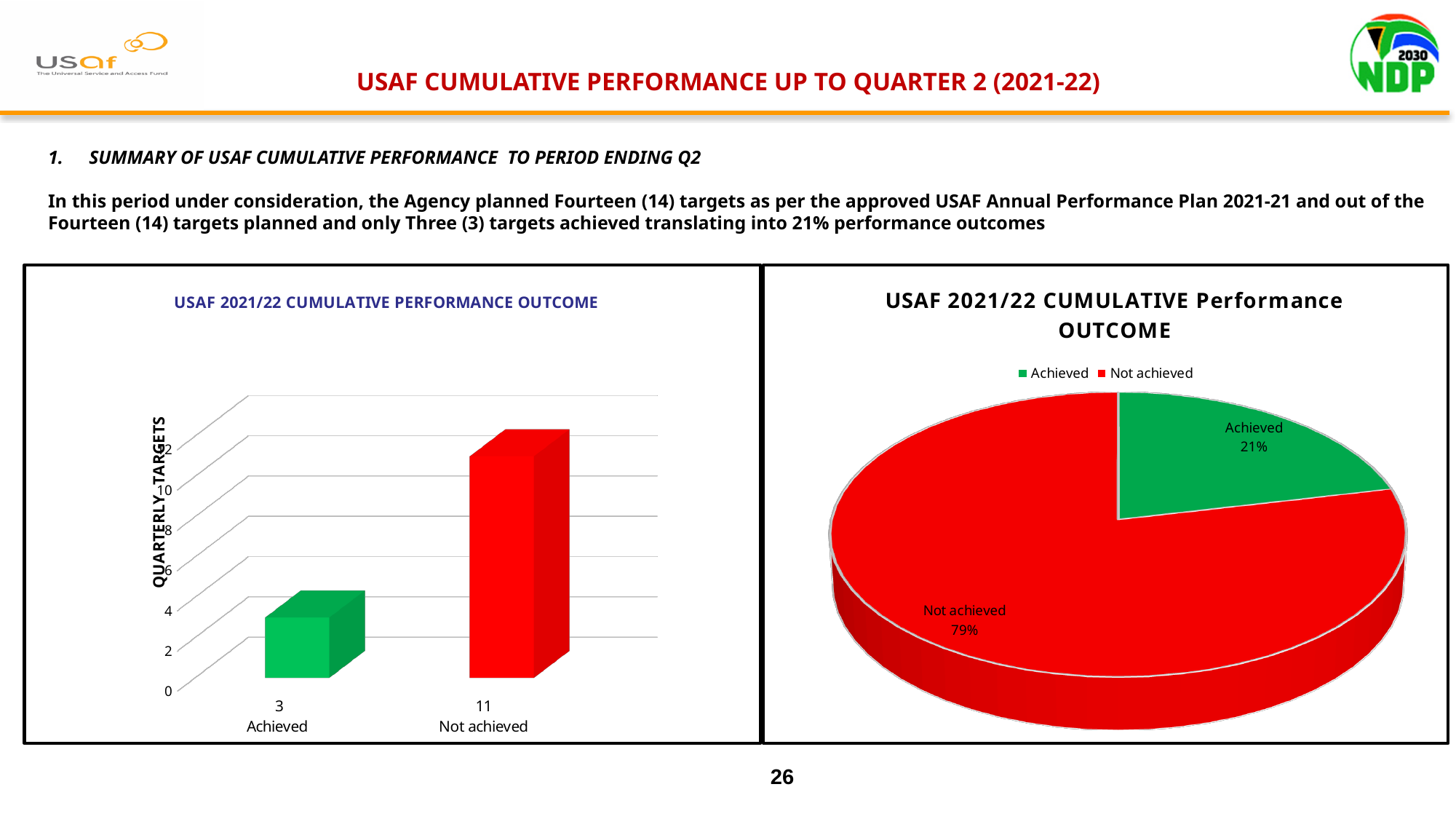
In the bar chart on the left, what is the value for Not achieved? 11 In the pie chart on the right, what share is labelled for Not achieved? 79% In the bar chart on the left, what is the difference between the Not achieved and Achieved values? 8 In the bar chart on the left, what is the y-axis title? QUARTERLY TARGETS What kind of chart is the chart on the left? Bar chart In the bar chart on the left, what is the value for Achieved? 3 In the pie chart on the right, how many entries does the legend list? 2 What kind of chart is the chart on the right? Pie chart In the bar chart on the left, how many categories are shown? 2 In the bar chart on the left, which category has the highest value? Not achieved In the pie chart on the right, what share is labelled for Achieved? 21% In the bar chart on the left, which category has the lowest value? Achieved